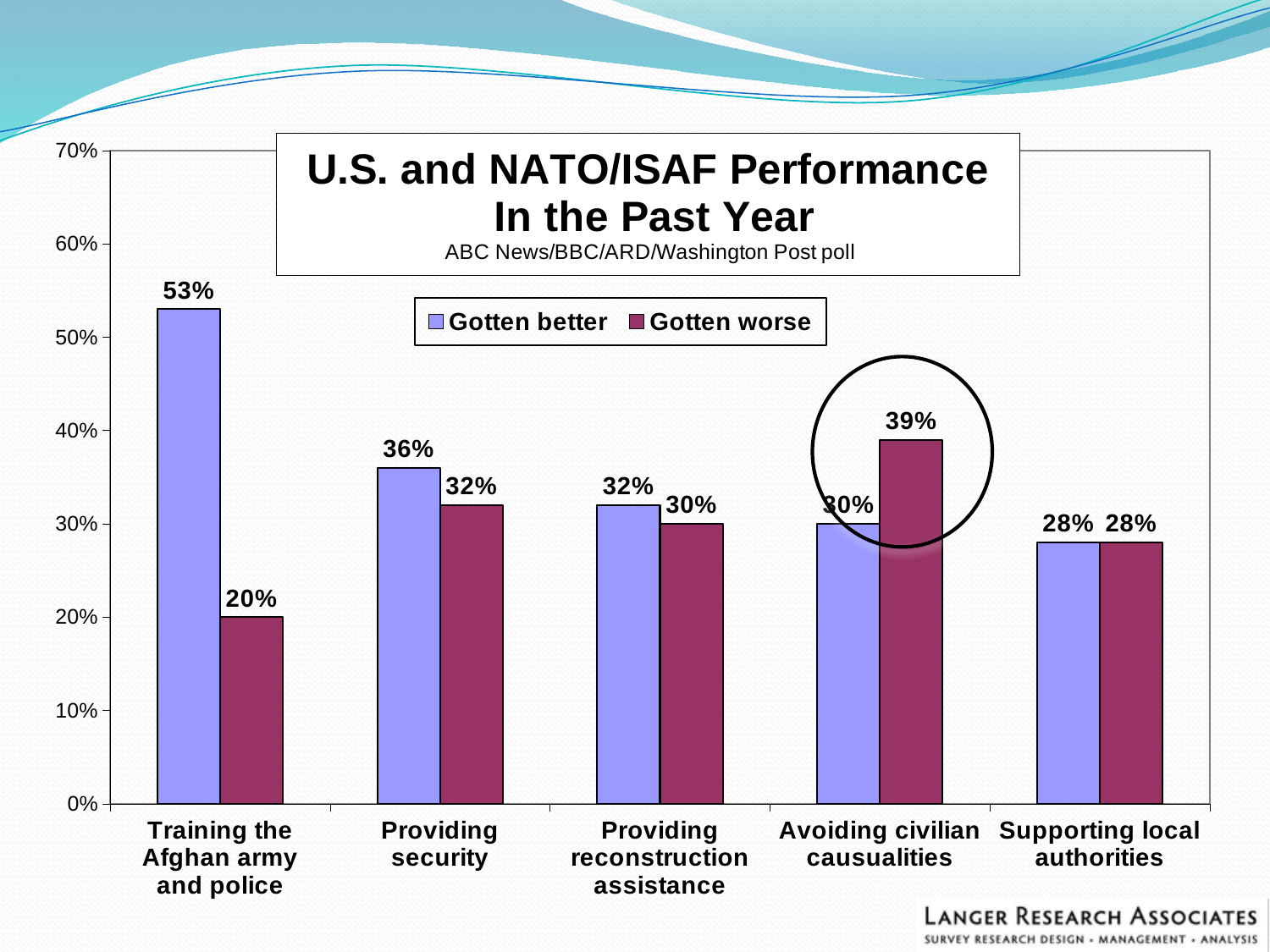
Which category has the lowest 'Gotten worse' value? Training the Afghan army and police For avoiding civilian casualties, which is larger: 'Gotten better' or 'Gotten worse'? Gotten worse What is the 'Gotten better' value for providing security? 36% How many series does the legend list? 2 Is the 'Gotten better' value for providing reconstruction assistance greater or less than 30%? greater What is the 'Gotten worse' value for avoiding civilian casualties? 39% What kind of chart is shown on the slide? Bar chart How many categories are shown on the x axis? 5 Which poll is cited in the chart subtitle? ABC News/BBC/ARD/Washington Post poll What is the difference between the 'Gotten better' and 'Gotten worse' values for training the Afghan army and police? 33% Which category has the highest 'Gotten better' value? Training the Afghan army and police What percentage said training the Afghan army and police has gotten better? 53%